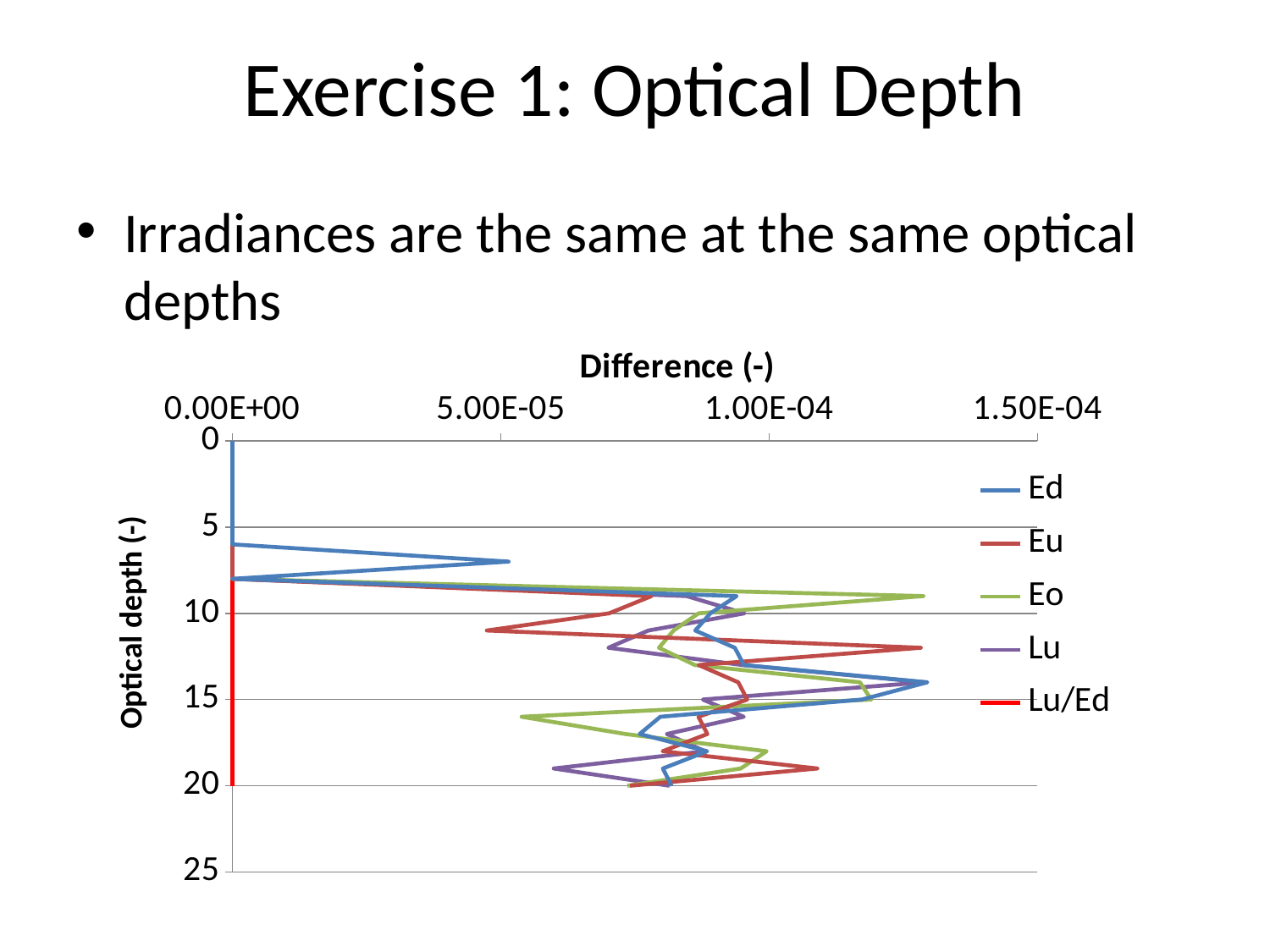
Is the Lu/Ed value at optical depth 15 greater or less than 5.00E-05? less Is the Eu value at optical depth 12 greater or less than 1.00E-04? greater At optical depth 9, which series has the larger Difference value, Eo or Eu? Eo What kind of chart is shown on the slide? line chart At optical depth 12, which series has the larger Difference value, Eu or Lu? Eu Is the Lu value at optical depth 19 greater or less than 1.00E-04? less What are the series names listed in the chart legend? Ed, Eu, Eo, Lu, Lu/Ed What is the title of the vertical axis of the chart? Optical depth (-) How many series does the chart legend list? 5